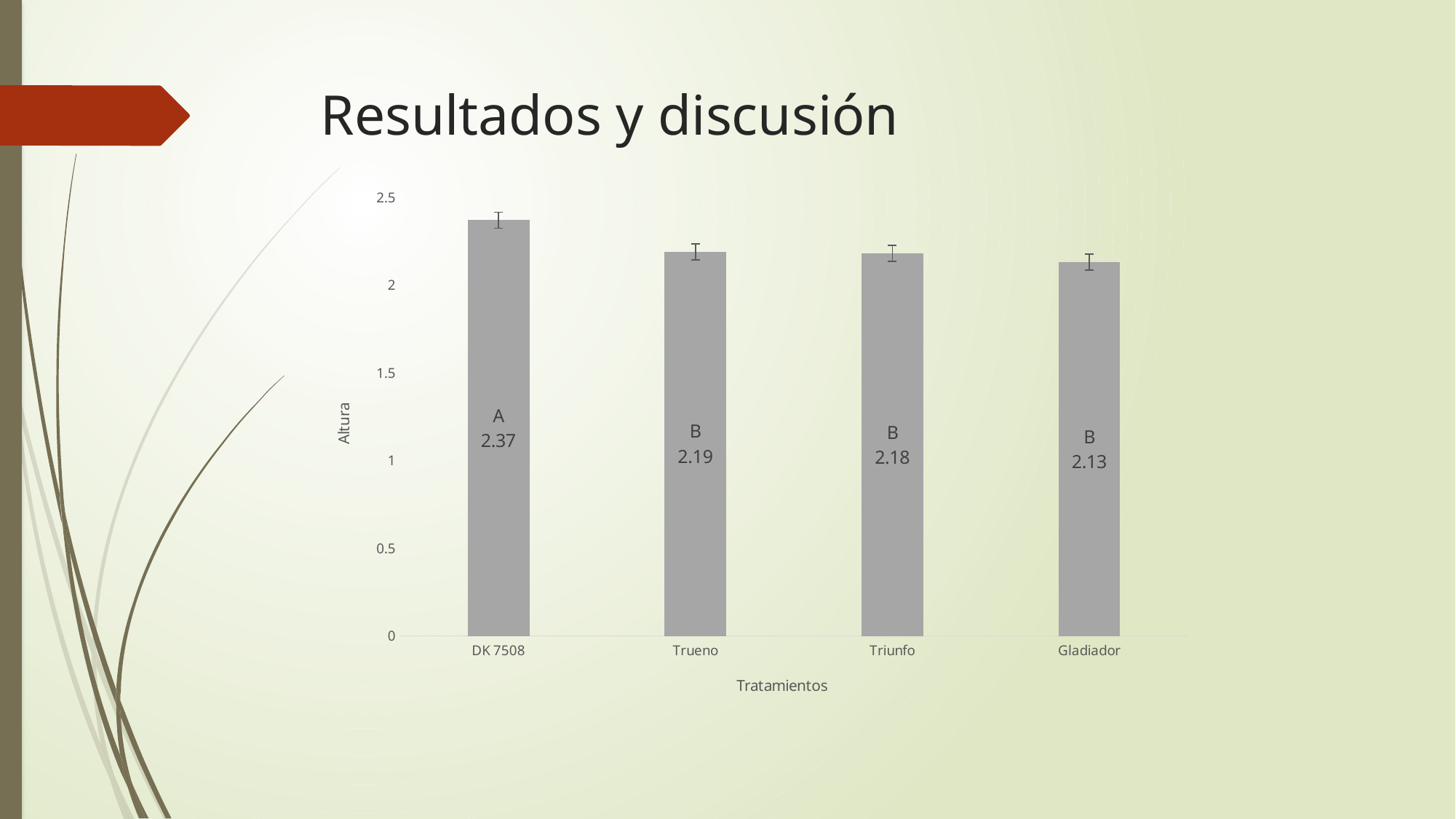
Which has a larger Altura value, DK 7508 or Triunfo? DK 7508 Which treatment has the highest Altura? DK 7508 Which treatment has the lowest Altura? Gladiador What is the Altura value for Trueno? 2.19 What is the Altura value for Gladiador? 2.13 What kind of chart is shown on the slide? Bar chart What statistical group letter is shown on the DK 7508 bar? A What is the Altura value for DK 7508? 2.37 Is the value for Gladiador greater or less than 2? greater What is the difference in Altura between DK 7508 and Gladiador? 0.24 How many treatments are shown on the x axis? 4 What is the difference in Altura between Trueno and Triunfo? 0.01